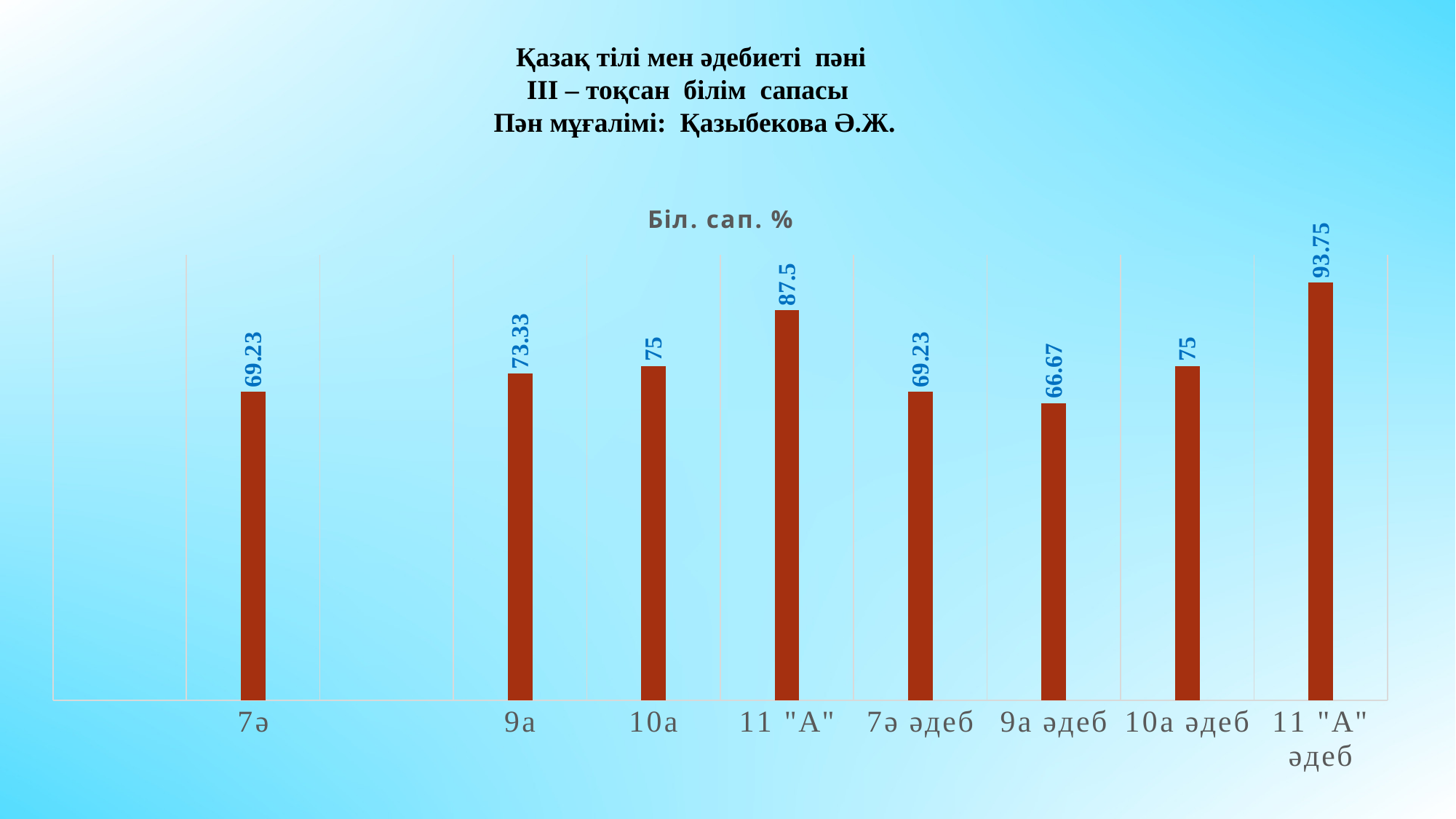
What is the difference between the values for 10а әдеб and 9а әдеб? 8.33 What is the value for 9а? 73.33 What is the difference between the values for 11 "А" әдеб and 11 "А"? 6.25 Which category has the highest value? 11 "А" әдеб What is the value for 11 "А" әдеб? 93.75 What kind of chart is shown on the slide? bar chart What is the value for 11 "А"? 87.5 Which category has the lowest value? 9а әдеб What is the value for 9а әдеб? 66.67 How many bars are plotted in the chart? 8 Which is larger, the value for 9а or the value for 7ә? 9а What is the title of the chart? Біл. сап. %